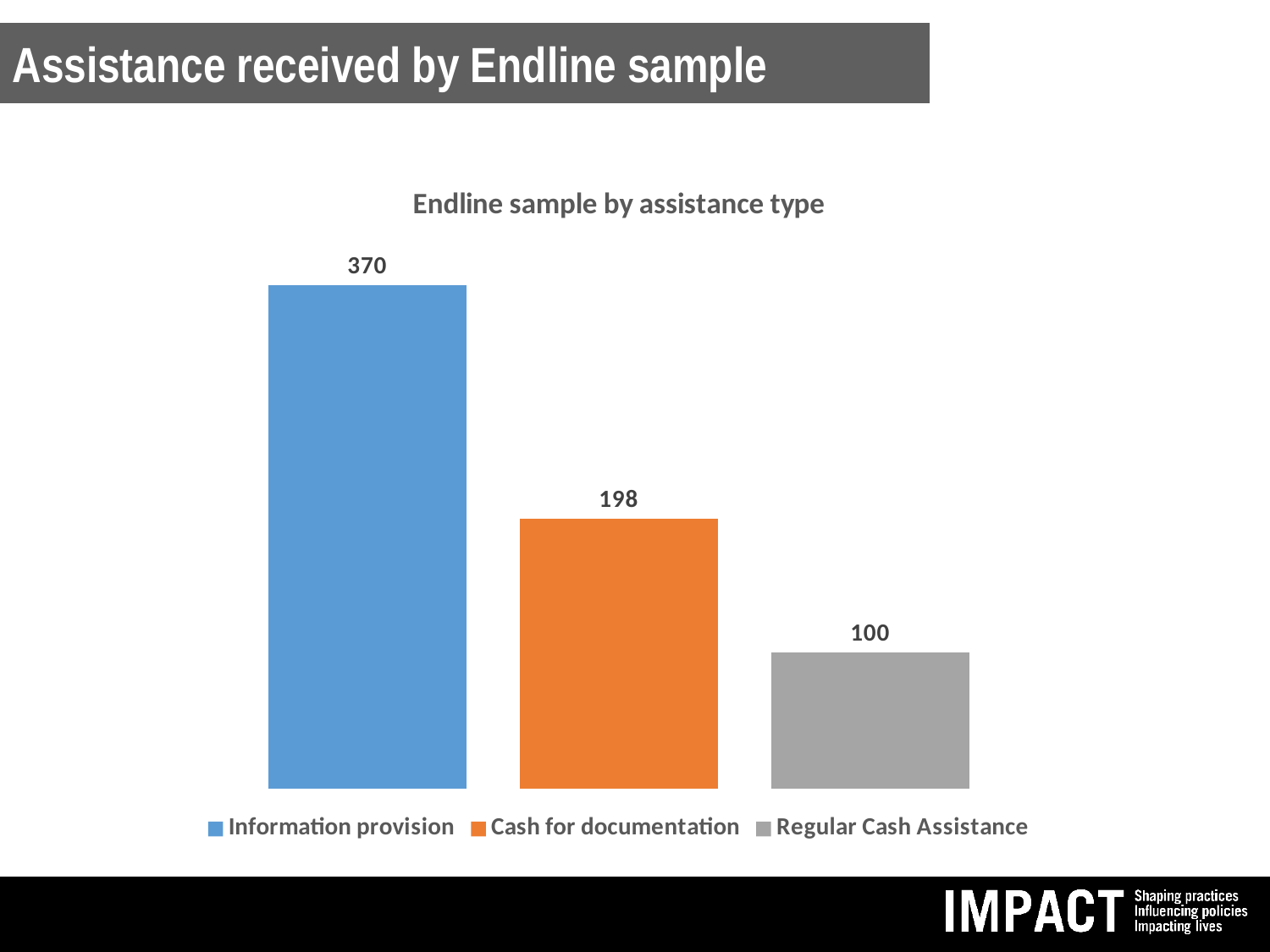
What is the difference between the values for Information provision and Cash for documentation? 172 What kind of chart is shown on the slide? Bar chart How many bars are shown in the chart? 3 What is the value for Information provision? 370 What is the value for Cash for documentation? 198 Which is larger, the value for Cash for documentation or the value for Regular Cash Assistance? Cash for documentation What is the title of the chart? Endline sample by assistance type What is the difference between the values for Cash for documentation and Regular Cash Assistance? 98 Which assistance type has the lowest value? Regular Cash Assistance How many entries does the legend list? 3 Which assistance type has the highest value? Information provision What is the value for Regular Cash Assistance? 100